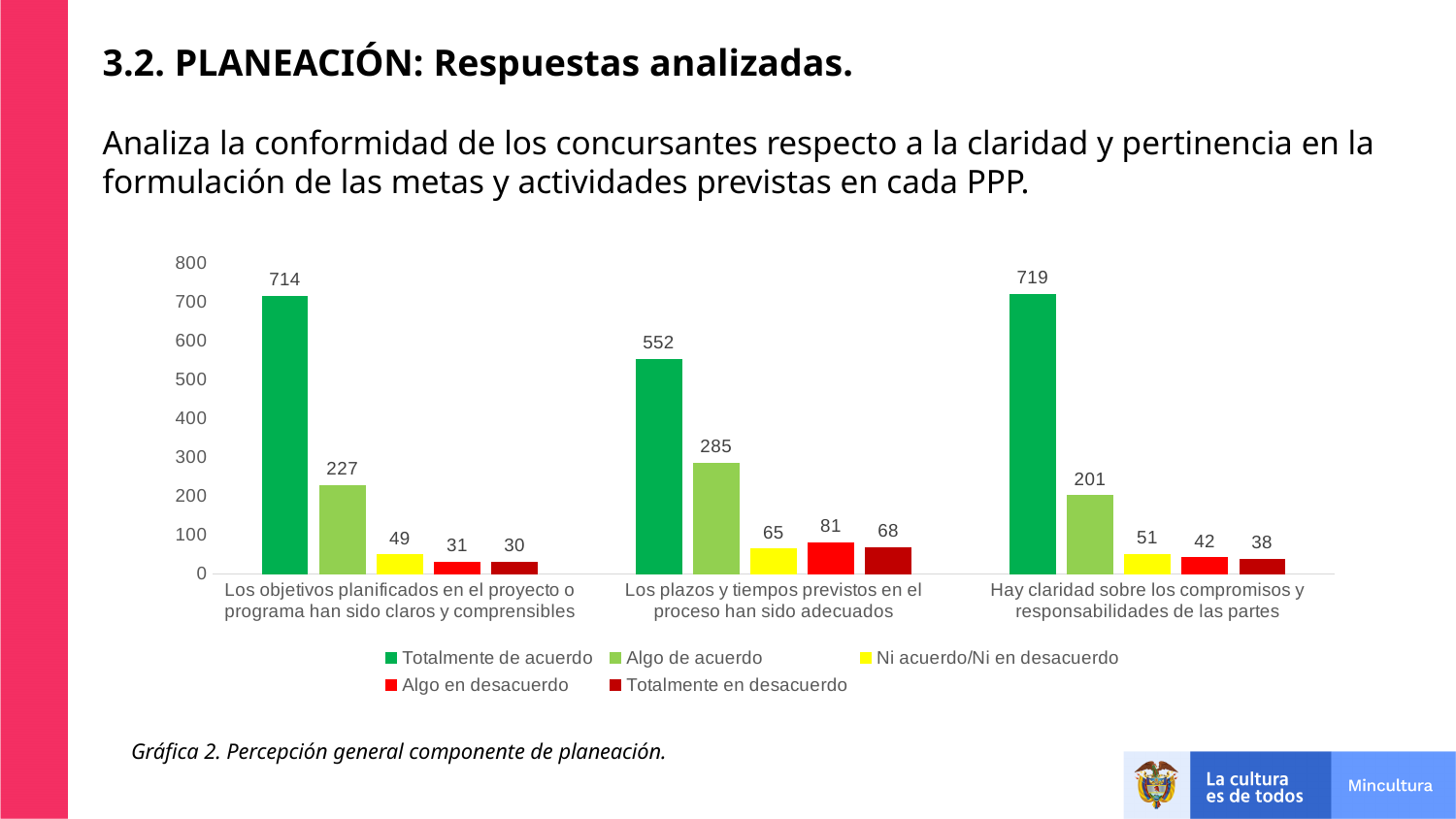
How many categories are shown on the x axis? 3 Which colour represents "Ni acuerdo/Ni en desacuerdo" in the chart? Yellow Is the value for "Algo de acuerdo" in "Los plazos y tiempos previstos en el proceso han sido adecuados" greater or less than 200? greater What is the value for "Ni acuerdo/Ni en desacuerdo" in the category "Los objetivos planificados en el proyecto o programa han sido claros y comprensibles"? 49 Which category has the highest value for "Totalmente de acuerdo"? Hay claridad sobre los compromisos y responsabilidades de las partes Which is larger: "Algo en desacuerdo" for "Los plazos y tiempos previstos en el proceso han sido adecuados" or "Algo en desacuerdo" for "Hay claridad sobre los compromisos y responsabilidades de las partes"? Los plazos y tiempos previstos en el proceso han sido adecuados What kind of chart is shown on the slide? Bar chart What is the value for "Algo de acuerdo" in the category "Hay claridad sobre los compromisos y responsabilidades de las partes"? 201 How many series does the legend list? 5 What is the value for "Totalmente de acuerdo" in the category "Los plazos y tiempos previstos en el proceso han sido adecuados"? 552 Which category has the lowest value for "Totalmente en desacuerdo"? Los objetivos planificados en el proyecto o programa han sido claros y comprensibles What is the difference between the "Totalmente de acuerdo" values for "Hay claridad sobre los compromisos y responsabilidades de las partes" and "Los plazos y tiempos previstos en el proceso han sido adecuados"? 167